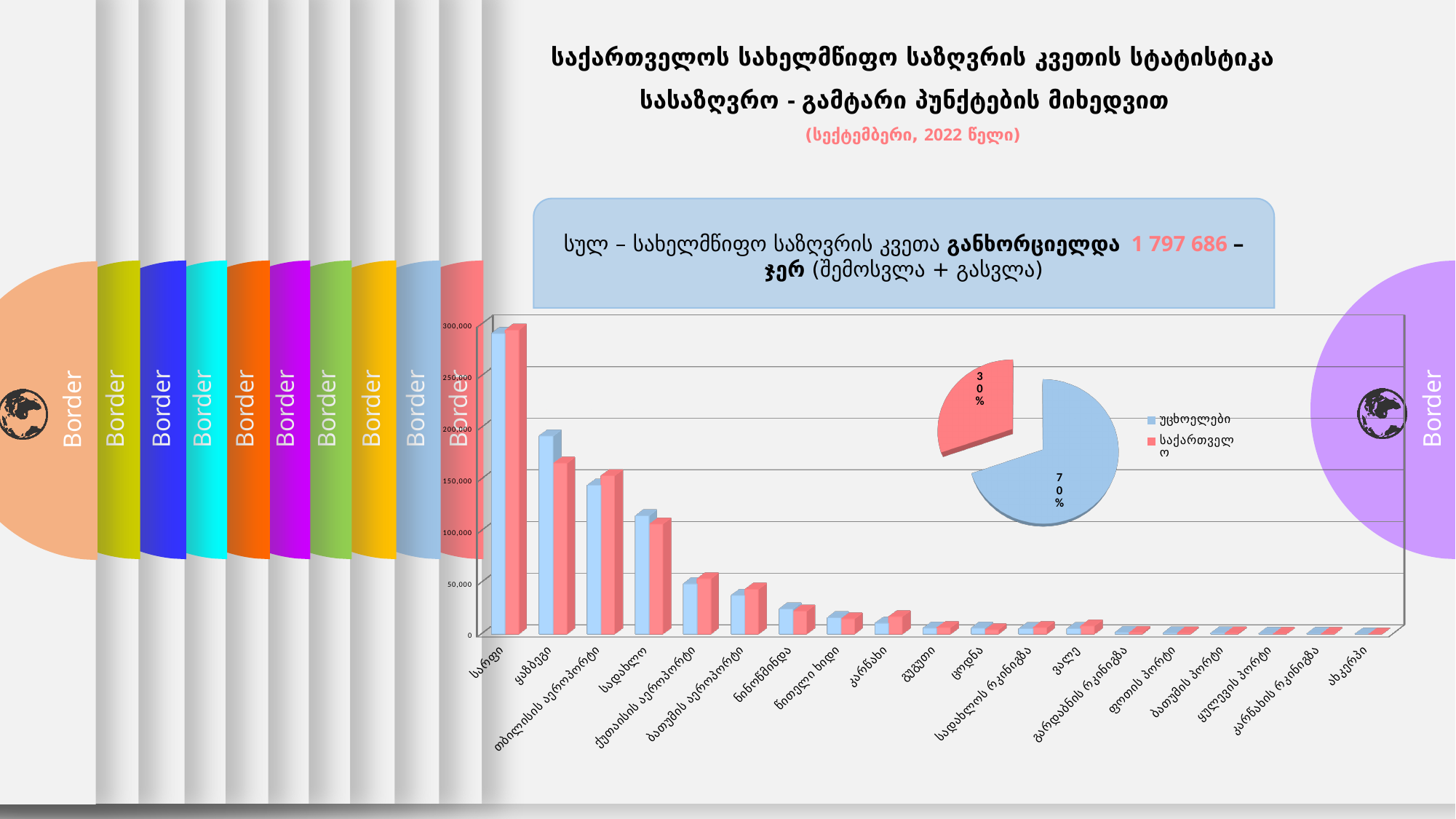
In the bar chart, which category has the highest values? სარფი In the pie chart, what share does საქართველო have? 30% What kind of chart is the chart on the left with the category labels along the bottom? Bar chart In the pie chart, which slice is larger, უცხოელები or საქართველო? უცხოელები How many series does the legend of the pie chart list? 2 How many categories are shown on the x axis of the bar chart? 19 In the pie chart, what share does უცხოელები have? 70% In the bar chart, do the values generally rise or fall from left to right along the x axis? fall